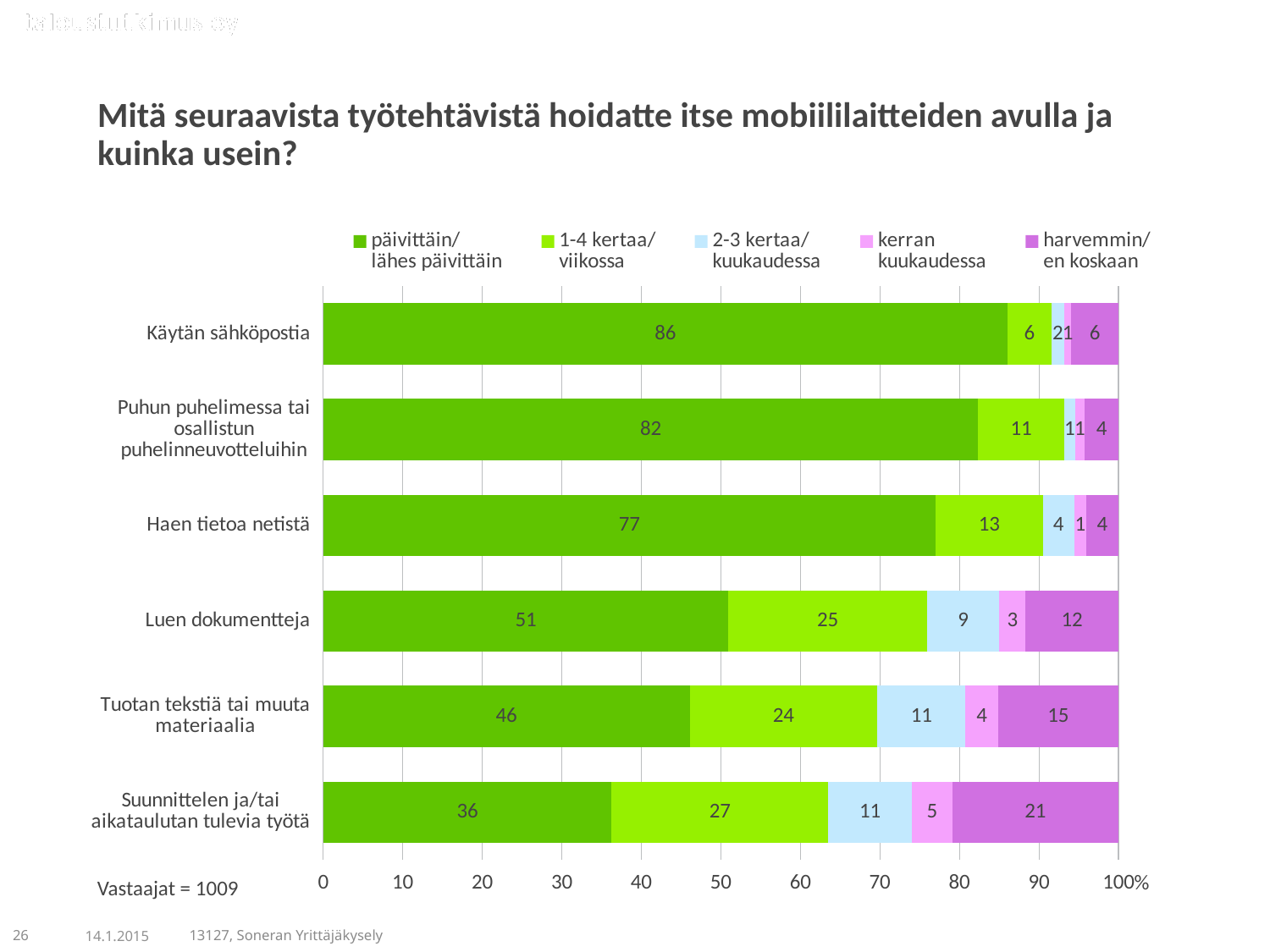
What is the number of respondents (Vastaajat) stated on the slide? 1009 What is the value of '1-4 kertaa/viikossa' for 'Luen dokumentteja'? 25 Which category has the lowest 'päivittäin/lähes päivittäin' value? Suunnittelen ja/tai aikataulutan tulevia työtä How many series does the legend list? 5 Which category has the highest 'päivittäin/lähes päivittäin' value? Käytän sähköpostia What is the value of 'päivittäin/lähes päivittäin' for 'Käytän sähköpostia'? 86 What is the difference between the 'päivittäin/lähes päivittäin' values for 'Haen tietoa netistä' and 'Luen dokumentteja'? 26 How many task categories are plotted on the chart? 6 Which is larger: the 'harvemmin/en koskaan' value for 'Luen dokumentteja' or for 'Tuotan tekstiä tai muuta materiaalia'? Tuotan tekstiä tai muuta materiaalia What is the value of 'harvemmin/en koskaan' for 'Suunnittelen ja/tai aikataulutan tulevia työtä'? 21 What kind of chart is shown on the slide? stacked bar chart What is the value of '2-3 kertaa/kuukaudessa' for 'Tuotan tekstiä tai muuta materiaalia'? 11